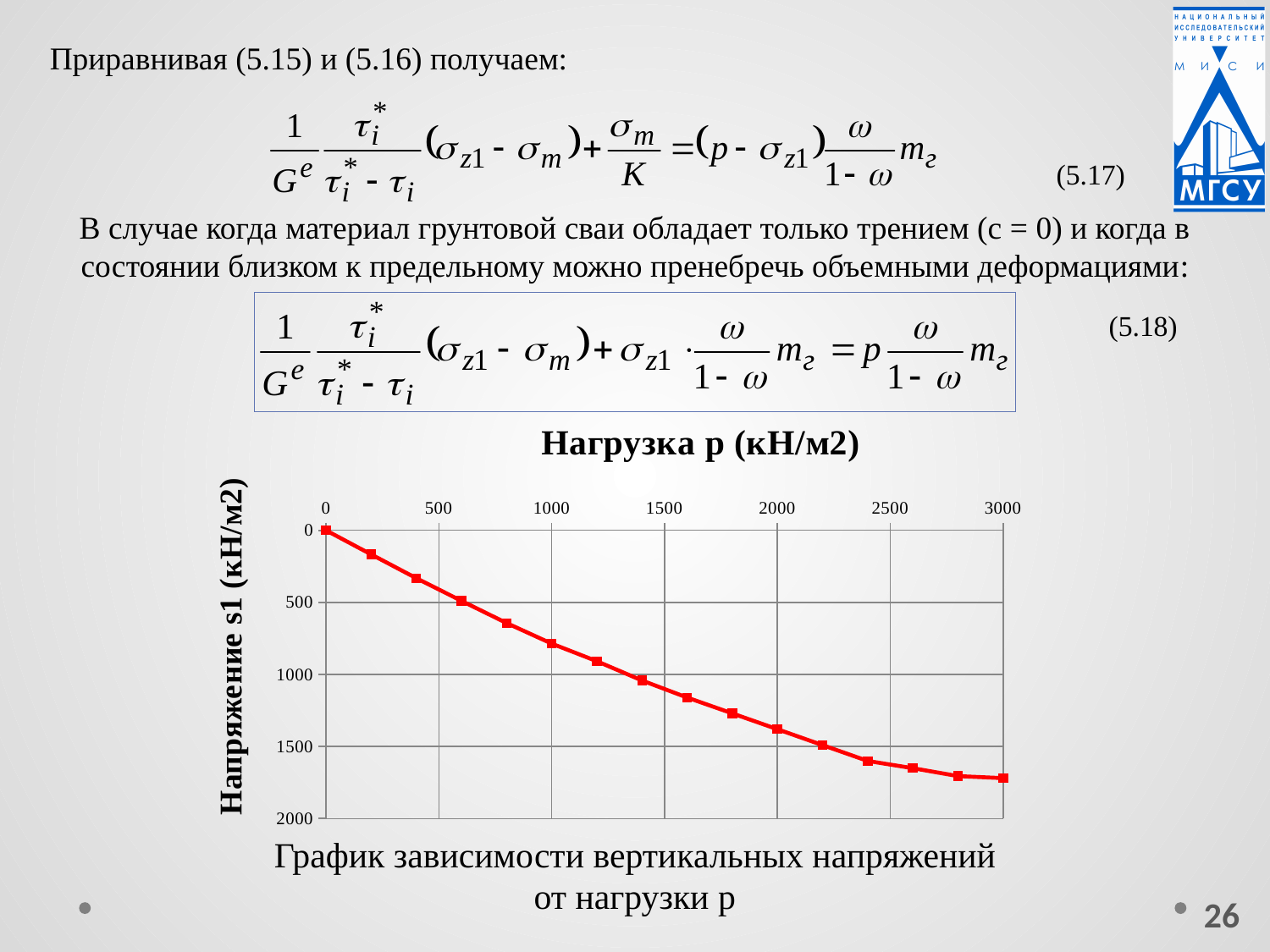
Which load value gives the larger Напряжение s1: p = 1000 or p = 2000? p = 2000 What kind of chart is shown on the slide? line chart What is the value of Напряжение s1 when the load p is 0? 0 How many data points are plotted on the line? 16 Is the value of Напряжение s1 at load p = 3000 greater or less than 1500? greater Is the value of Напряжение s1 at load p = 1000 greater or less than 1000? less What is the label of the horizontal axis of the chart? Нагрузка p (кН/м2) What colour is the plotted line? red Is the value of Напряжение s1 at load p = 2000 greater or less than 1000? greater At which load p is Напряжение s1 the lowest? 0